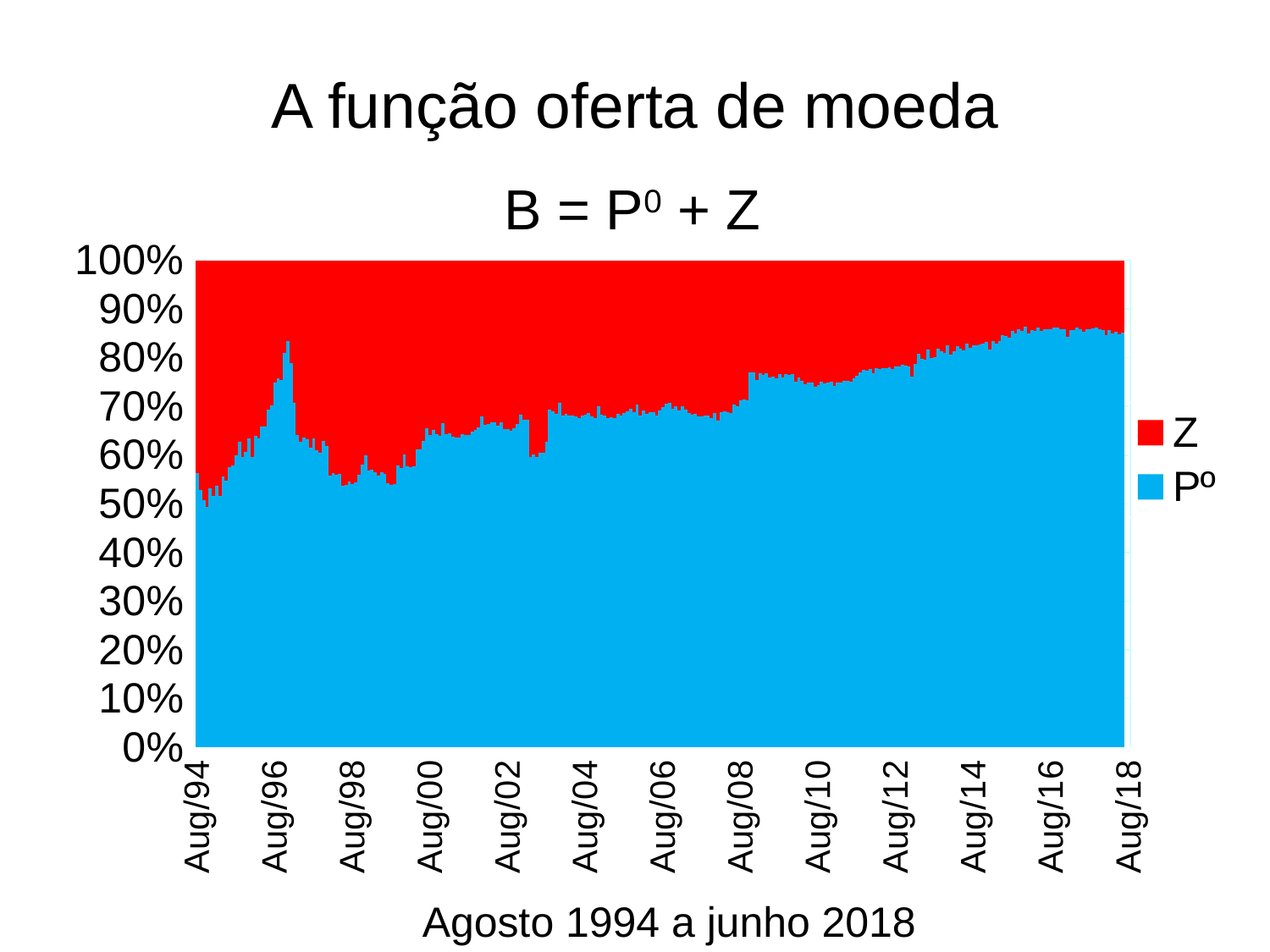
At Aug/98, which series has the larger share, Pº or Z? Pº Is the share of Pº at Aug/98 greater or less than 60%? less Is the share of Pº at Aug/10 greater or less than 70%? greater Is the share of Z at Aug/16 greater or less than 20%? less What kind of chart is shown on the slide? Stacked bar chart What is the title of the slide above the chart? A função oferta de moeda At Aug/18, which series has the larger share, Pº or Z? Pº How many series does the legend list? 2 Does the share of Pº rise or fall from Aug/94 to Aug/18? Rise Which series is shown in red? Z How many year labels are shown on the x axis? 13